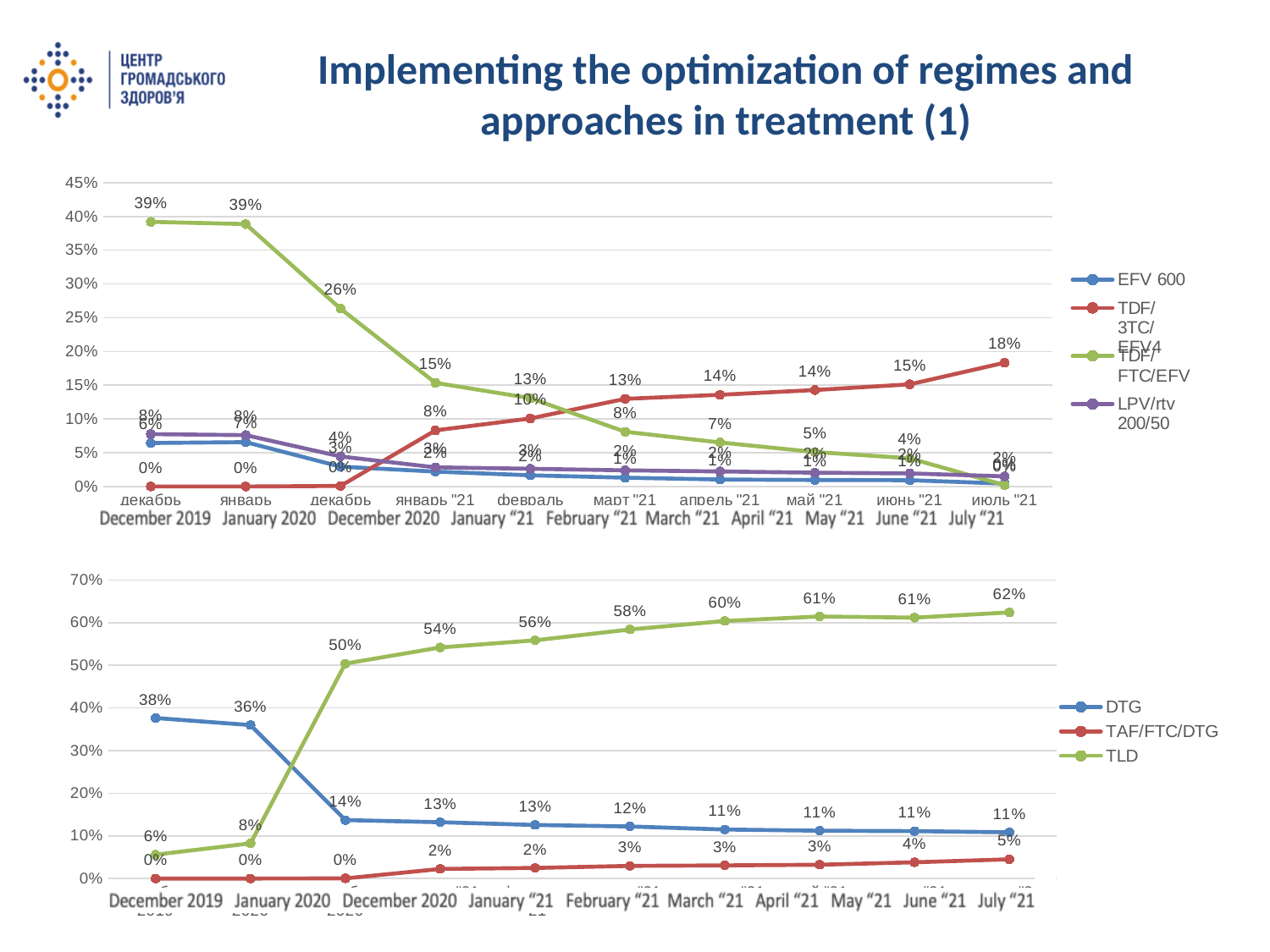
In the bottom chart, in which period does TLD reach its highest value? July '21 In the bottom chart, does the TLD series rise or fall from December 2019 to July '21? rise In the bottom chart, what is the value for TAF/FTC/DTG in July '21? 5% In the top chart, what is the value for TDF/FTC/EFV in December 2020? 26% How many series does the legend of the bottom chart list? 3 In the bottom chart, what is the value for TLD in July '21? 62% In the bottom chart, what is the difference between TLD and DTG in July '21? 51% In the bottom chart, which is larger in December 2019: DTG or TLD? DTG What type of chart is the bottom chart? line chart In the top chart, does the TDF/FTC/EFV series rise or fall from December 2019 to July '21? fall In the bottom chart, what is the value for DTG in December 2019? 38% In the top chart, what is the value for the red TDF/3TC/EFV series in July '21? 18%